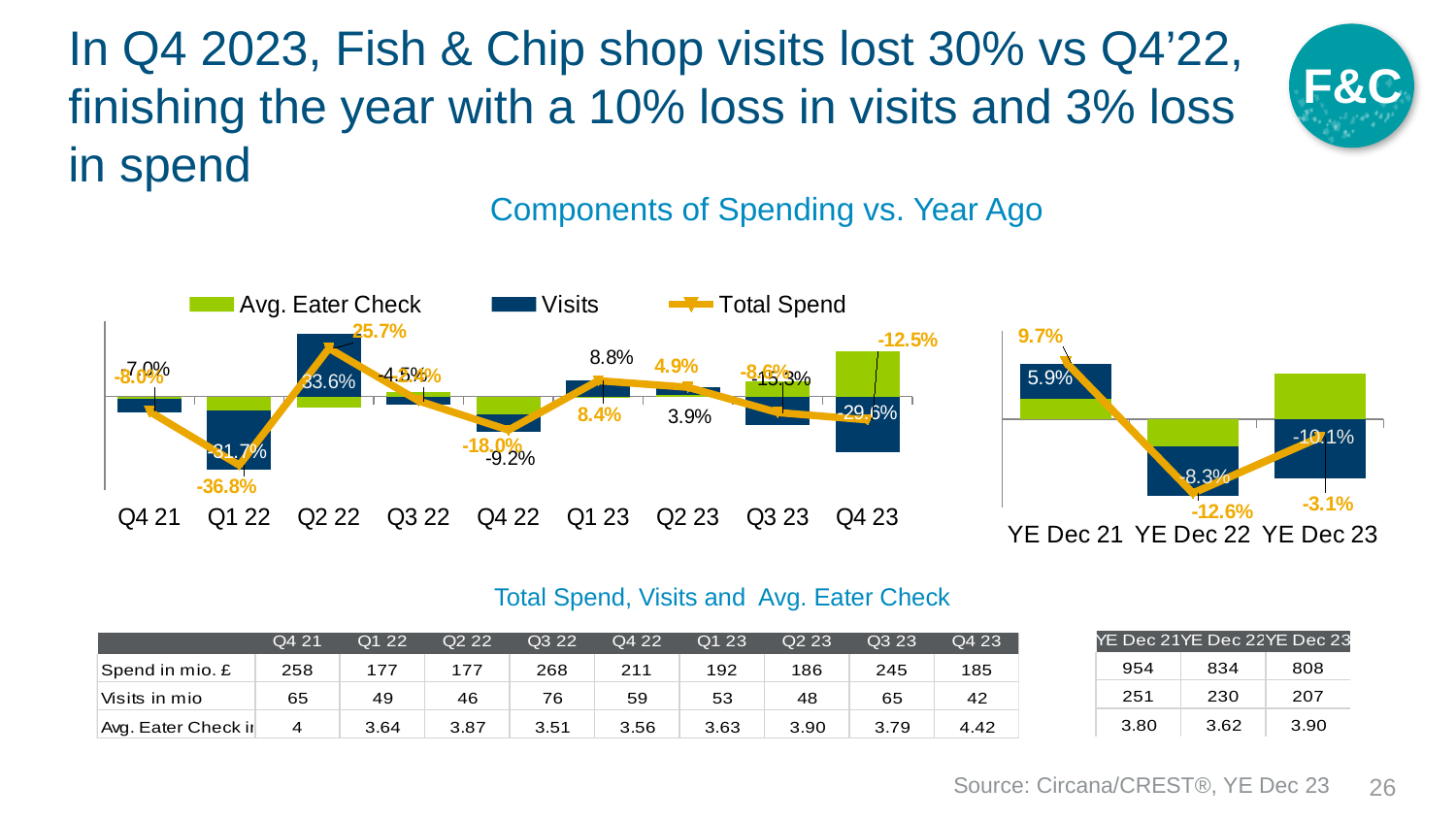
In the quarterly 'Components of Spending vs. Year Ago' chart, what is the Visits value for Q4 23? -29.6% How many quarters are shown on the x axis of the quarterly 'Components of Spending vs. Year Ago' chart? 9 How many series does the legend of the 'Components of Spending vs. Year Ago' chart list? 3 What kind of chart is the 'Components of Spending vs. Year Ago' chart? A combination bar and line chart In the quarterly 'Components of Spending vs. Year Ago' chart, which quarter has the lowest Total Spend value? Q1 22 In the quarterly 'Components of Spending vs. Year Ago' chart, which quarter has the highest Total Spend value? Q2 22 In the year-end chart on the right (YE Dec 21 to YE Dec 23), do the Visits values rise or fall from YE Dec 21 to YE Dec 23? Fall In the year-end chart on the right (YE Dec 21 to YE Dec 23), what is the Total Spend value for YE Dec 23? -3.1% In the quarterly 'Components of Spending vs. Year Ago' chart, which is larger for Q4 23: the Visits value or the Total Spend value? Total Spend (-12.5%) In the quarterly 'Components of Spending vs. Year Ago' chart, what is the Total Spend value for Q4 22? -18.0% In the quarterly 'Components of Spending vs. Year Ago' chart, what is the difference in percentage points between the Visits value (33.6%) and the Total Spend value (25.7%) for Q2 22? 7.9 percentage points In the quarterly 'Components of Spending vs. Year Ago' chart, what is the Total Spend value for Q1 22? -36.8%